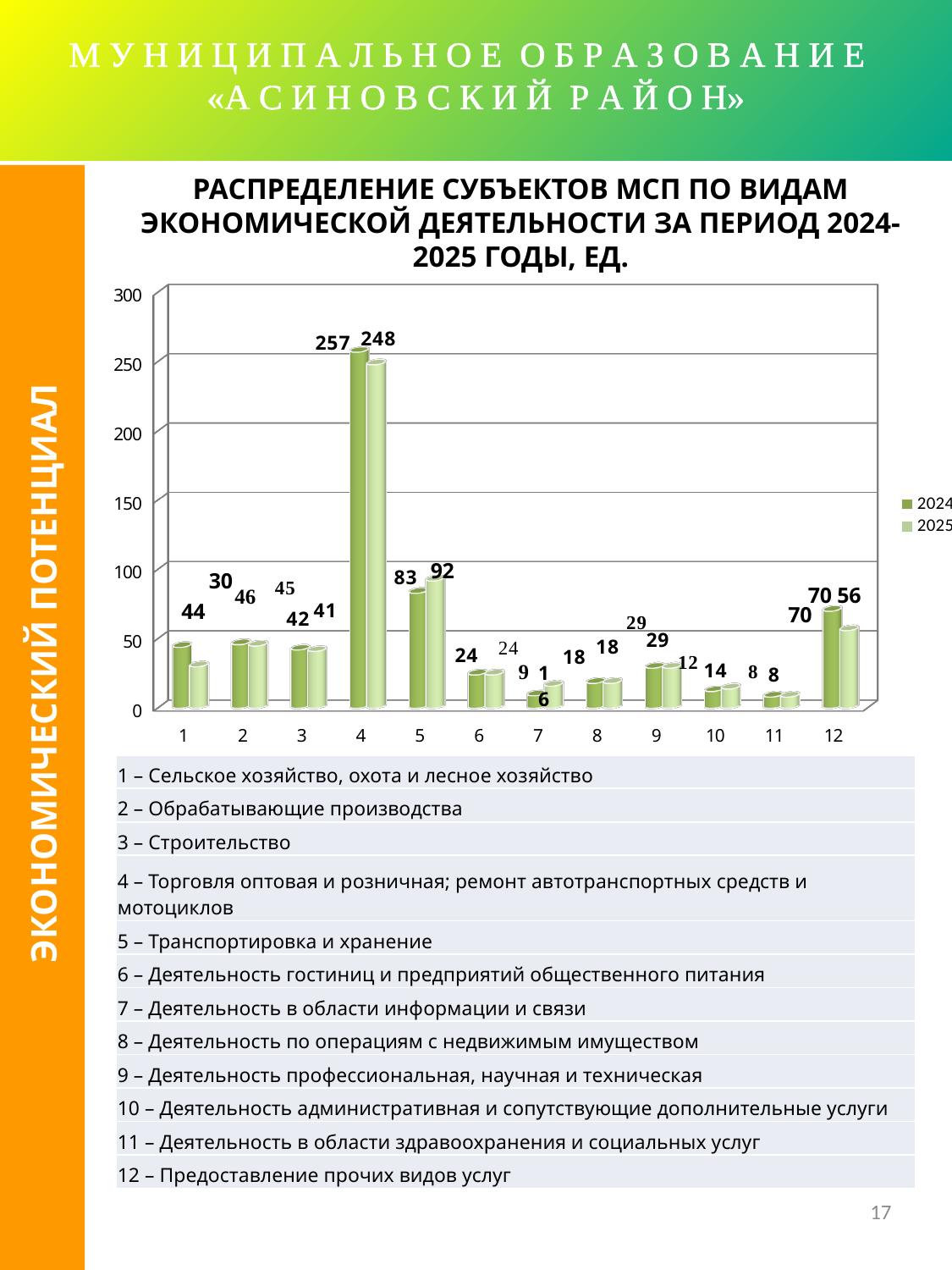
What is the 2024 value for category 1 (Сельское хозяйство, охота и лесное хозяйство)? 44 What kind of chart is shown on the slide? bar chart How many categories are shown along the x axis of the chart? 12 Is the 2024 value for category 4 greater or less than 250? greater What is the 2025 value for category 4 (Торговля оптовая и розничная)? 248 For category 5, which year has the larger value, 2024 or 2025? 2025 What are the two entries in the chart legend? 2024 and 2025 How many series does the legend list? 2 Which category has the highest 2024 value? 4 What is the 2025 value for category 5 (Транспортировка и хранение)? 92 What is the 2024 value for category 4 (Торговля оптовая и розничная)? 257 What is the difference between the 2024 and 2025 values for category 4? 9